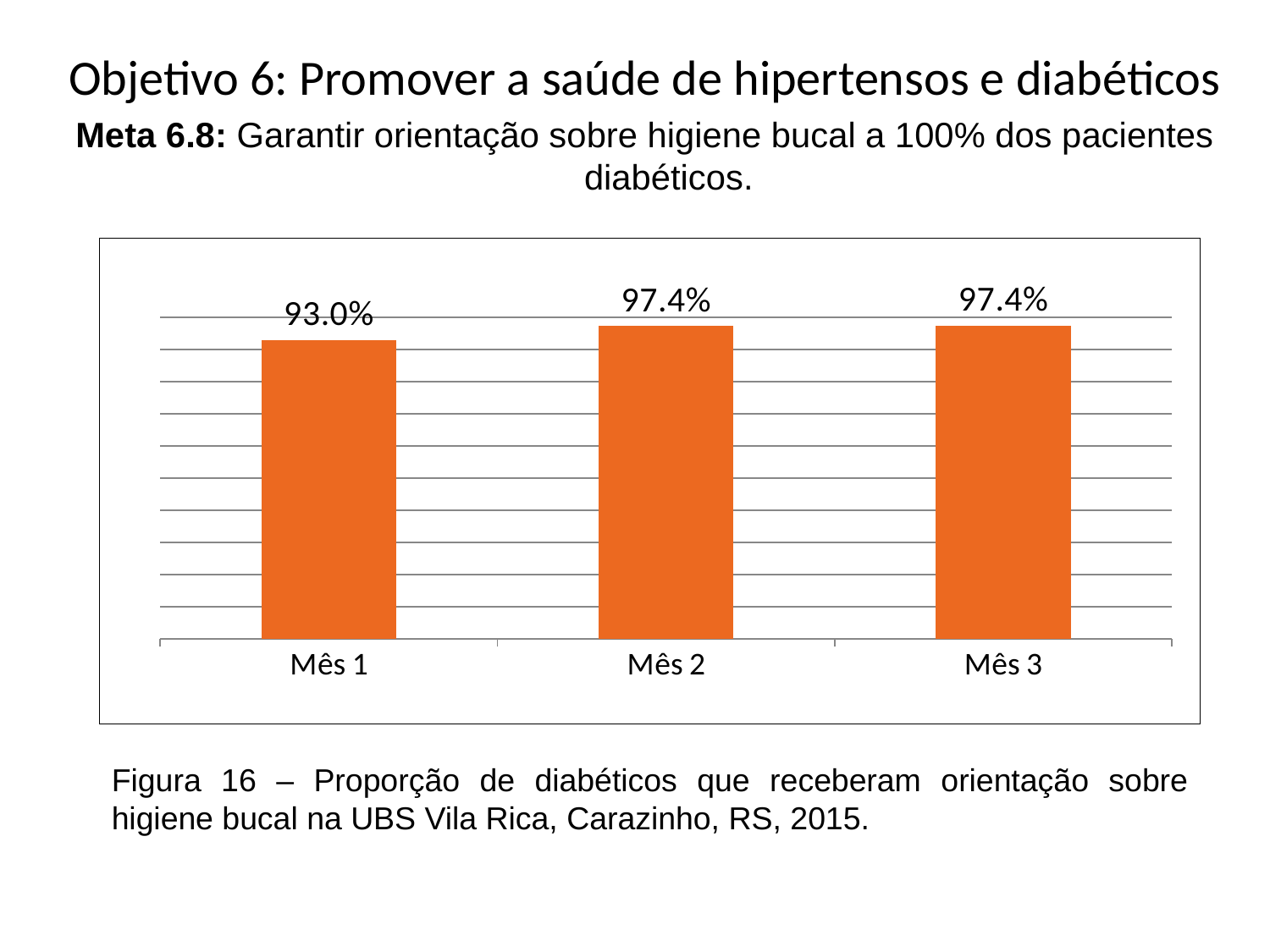
Do the values for Mês 2 and Mês 3 differ? No, both are 97.4% What kind of chart is shown on the slide? Bar chart What is the value for Mês 3? 97.4% What is the difference between the values for Mês 2 and Mês 1? 4.4% What colour are the bars in the chart? Orange What is the value for Mês 2? 97.4% Do the values rise or fall from Mês 1 to Mês 2? Rise What is the value for Mês 1? 93.0% Which is larger, the value for Mês 1 or the value for Mês 3? Mês 3 What is the figure number given in the caption below the chart? Figura 16 How many categories are shown on the x axis? 3 Which month has the lowest value? Mês 1